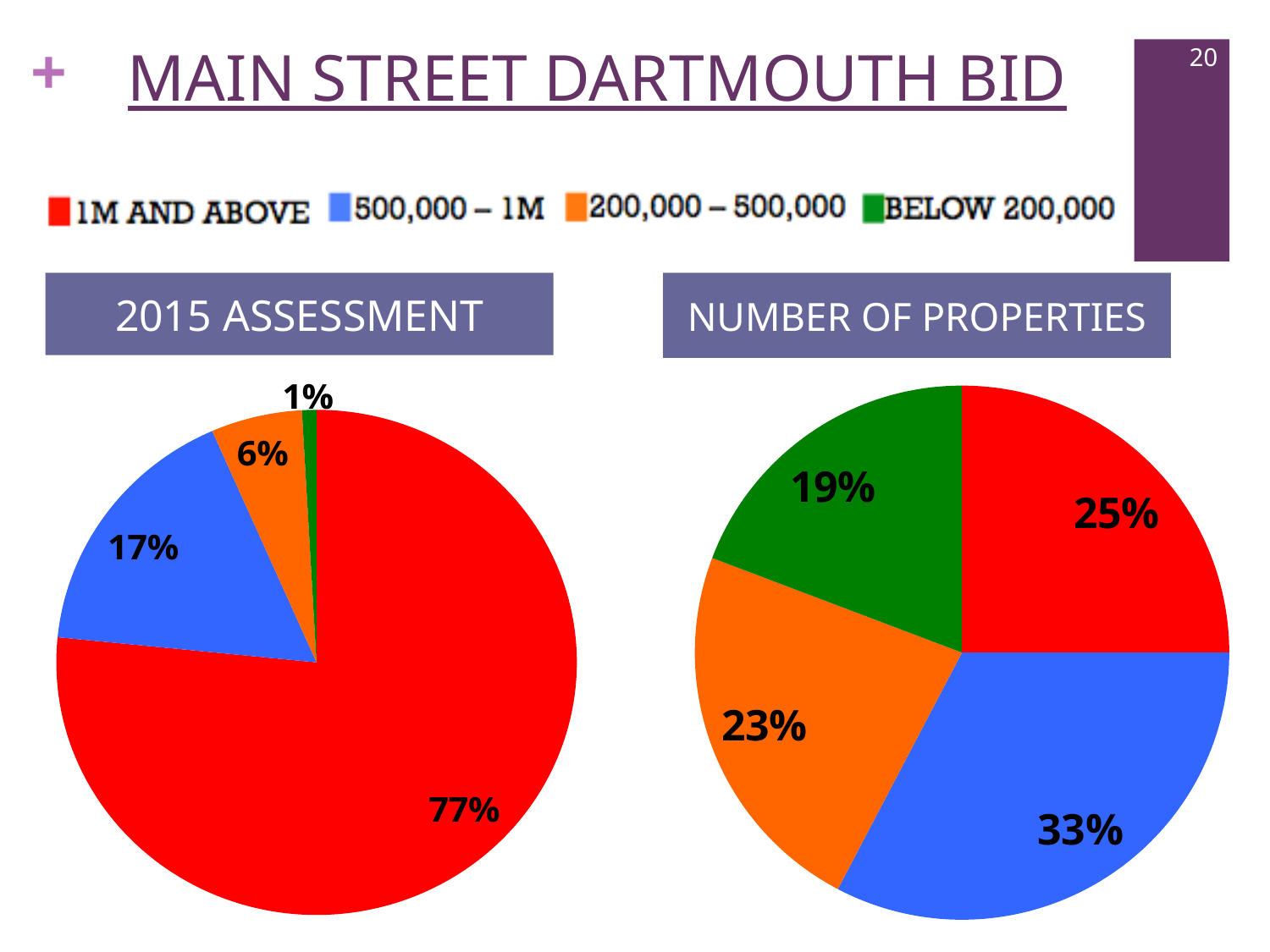
In the Number of Properties chart, what share does the 200,000 – 500,000 category have? 23% In the 2015 Assessment chart, what share does the 500,000 – 1M category have? 17% In the Number of Properties chart, which category has the smallest share? BELOW 200,000 In the Number of Properties chart, which category has the largest share? 500,000 – 1M In the 2015 Assessment chart, what share does the BELOW 200,000 category have? 1% How many categories does the legend list? 4 In the 2015 Assessment chart, which category has the largest share? 1M AND ABOVE In the 2015 Assessment chart, what is the difference between the 1M AND ABOVE share and the 500,000 – 1M share? 60% In the Number of Properties chart, which is larger: the share for 1M AND ABOVE or the share for 200,000 – 500,000? 1M AND ABOVE What kind of chart is the 2015 Assessment chart? Pie chart